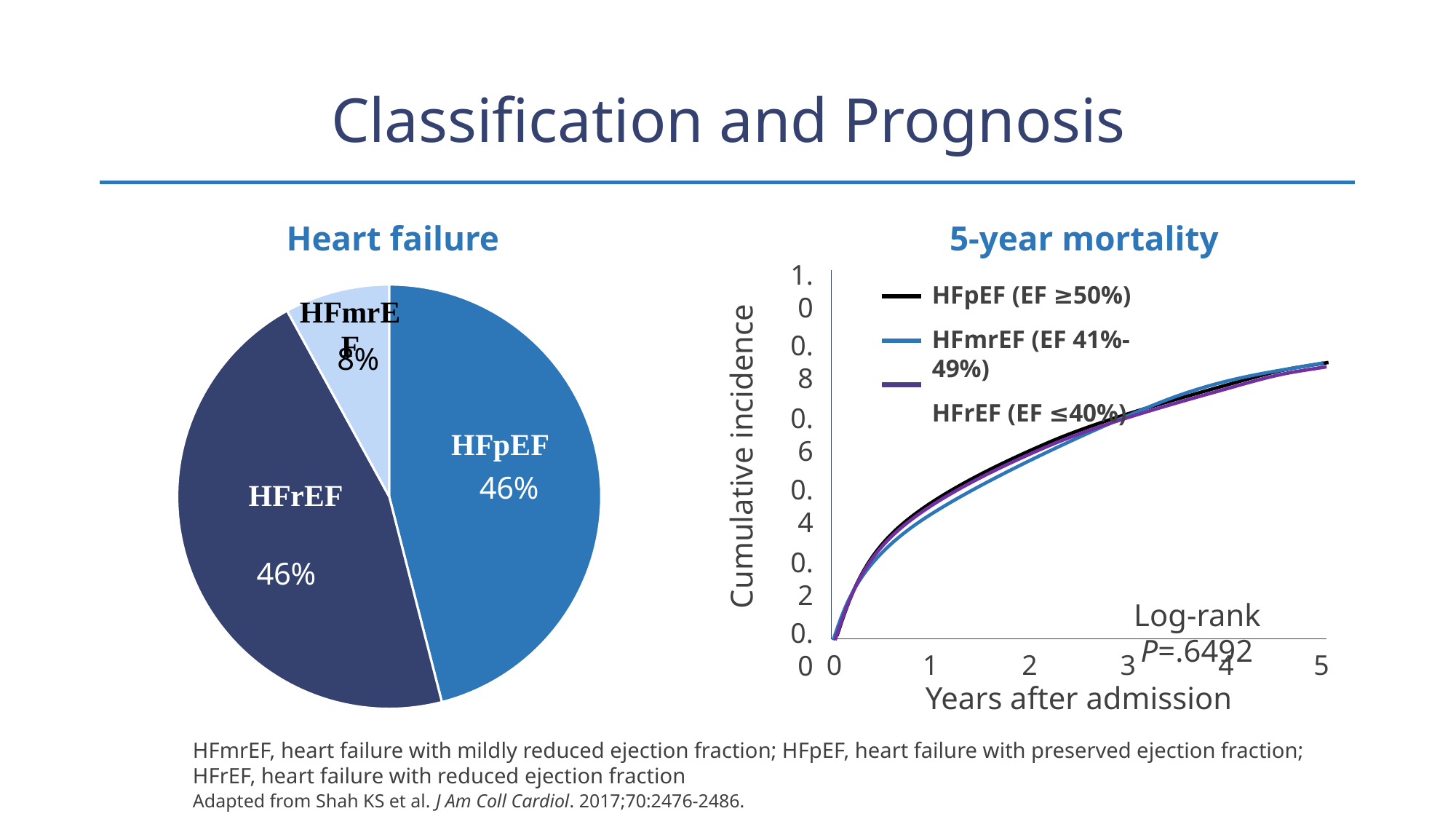
What kind of chart is the 5-year mortality chart? Line chart In the Heart failure pie chart, what share is labelled for HFmrEF? 8% In the 5-year mortality chart, is the cumulative incidence for HFpEF at 5 years greater or less than 0.8? greater In the Heart failure pie chart, how many percentage points larger is the HFpEF share than the HFmrEF share? 38 In the 5-year mortality chart, do the cumulative incidence curves rise or fall as years after admission increase? Rise In the Heart failure pie chart, how many slices are there? 3 In the Heart failure pie chart, what share is labelled for HFpEF? 46% In the Heart failure pie chart, which is larger, the HFpEF slice or the HFmrEF slice? HFpEF What kind of chart is the chart on the left of the slide? Pie chart In the Heart failure pie chart, what share is labelled for HFrEF? 46% In the Heart failure pie chart, which category has the smallest slice? HFmrEF In the 5-year mortality chart, how many series does the legend list? 3